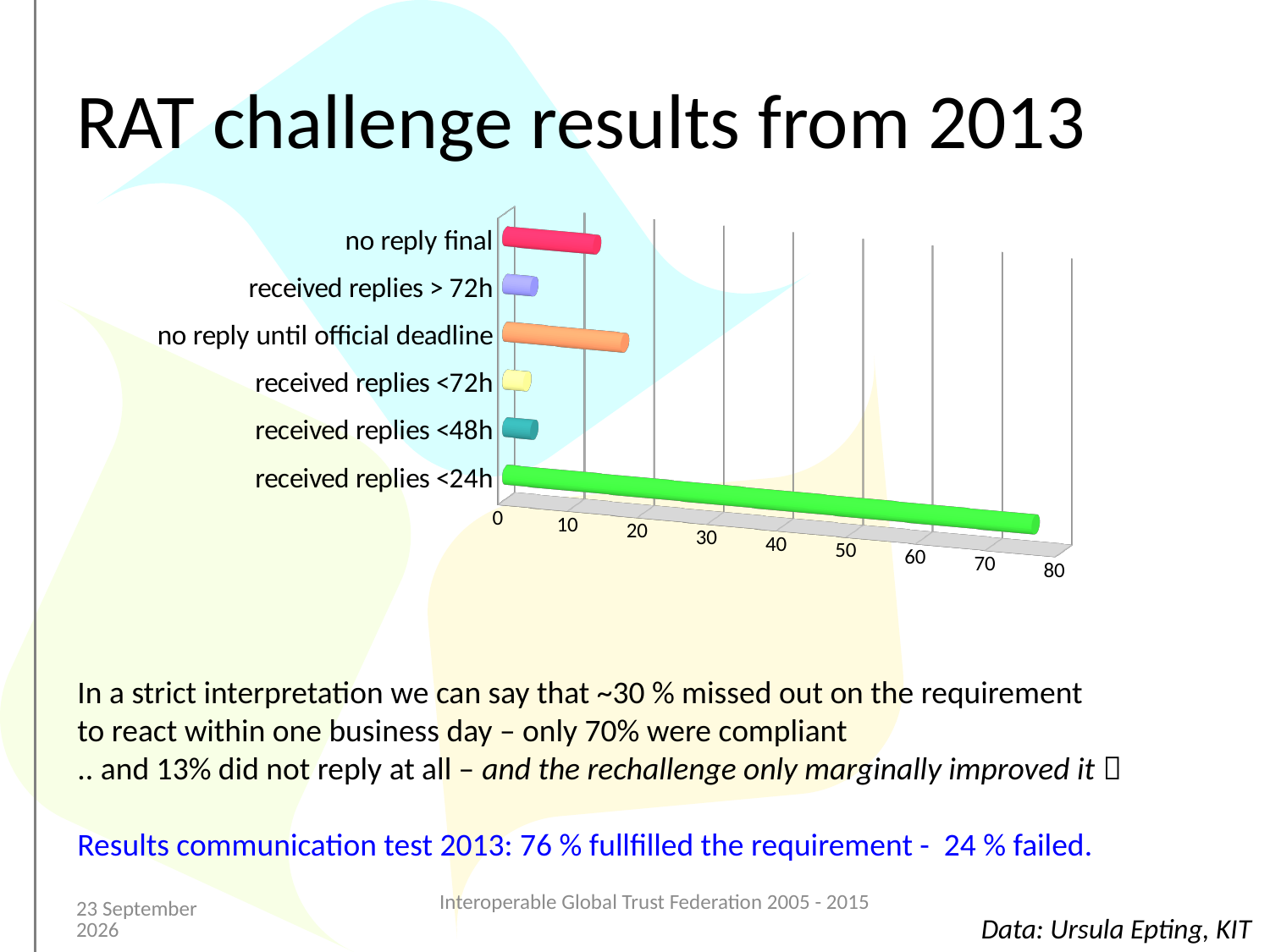
Which is larger, the value for received replies <24h or the value for no reply final? received replies <24h Is the value for no reply final greater or less than 20? less Is the value for received replies > 72h greater or less than 10? less How many categories are plotted in the chart? 6 What colour is the bar for received replies <24h? green Is the value for received replies <24h greater or less than 70? greater What is the highest tick value shown on the value axis of the chart? 80 Which category has the highest value in the chart? received replies <24h Which is larger, the value for no reply final or the value for received replies > 72h? no reply final What kind of chart is shown on the slide? bar chart